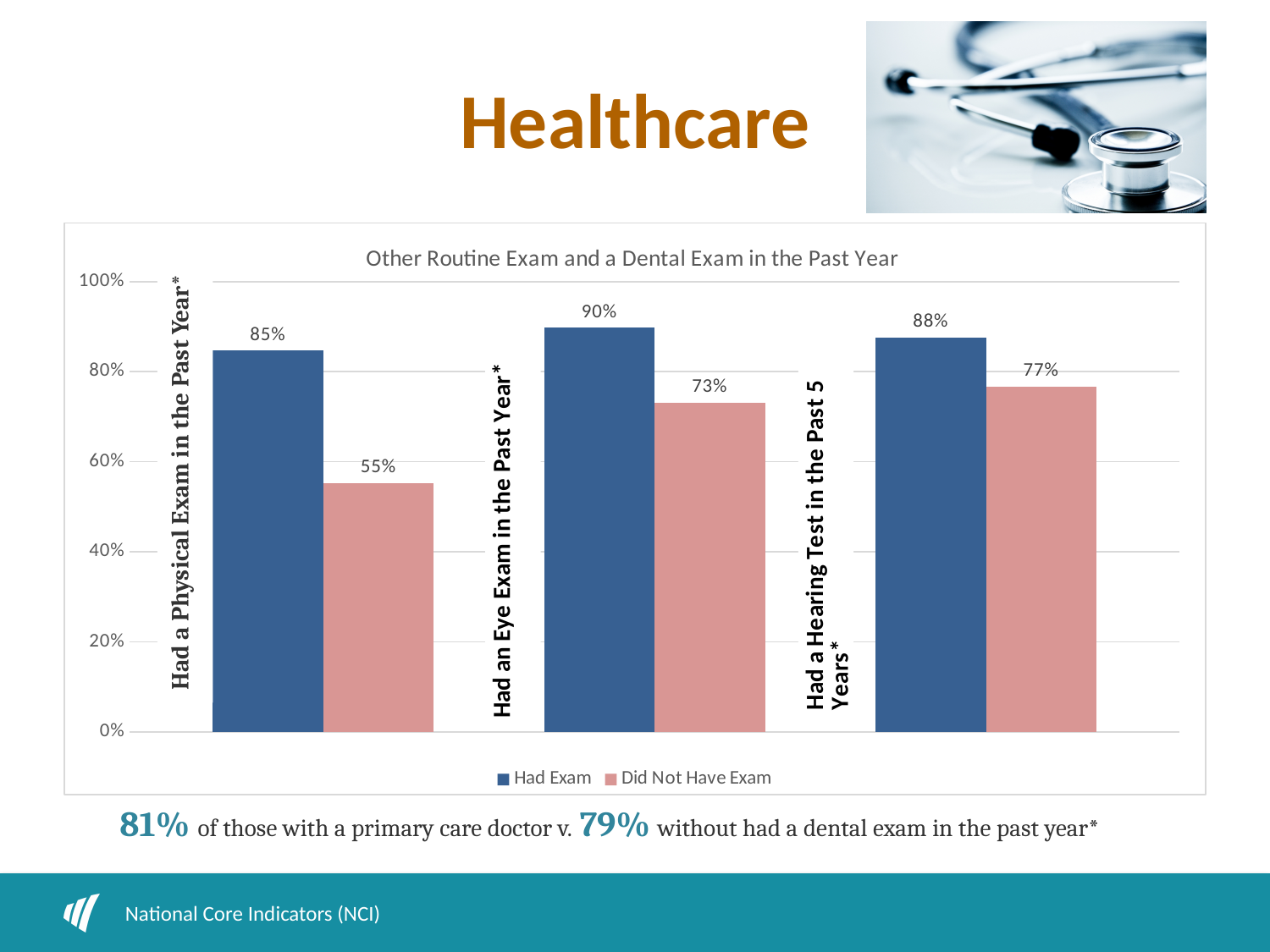
What is the value for "Had Exam" in the "Had a Physical Exam in the Past Year" category? 85% What kind of chart is shown on the slide? Bar chart What is the difference between "Had Exam" and "Did Not Have Exam" for "Had a Hearing Test in the Past 5 Years"? 11% Which category has the highest "Had Exam" value? Had an Eye Exam in the Past Year What is the difference between "Had Exam" and "Did Not Have Exam" for "Had a Physical Exam in the Past Year"? 30% What is the title of the chart? Other Routine Exam and a Dental Exam in the Past Year What is the value for "Did Not Have Exam" in the "Had an Eye Exam in the Past Year" category? 73% Which category has the lowest "Did Not Have Exam" value? Had a Physical Exam in the Past Year Which is larger: "Did Not Have Exam" for the eye exam category or "Did Not Have Exam" for the hearing test category? Hearing test category How many series does the legend list? 2 What is the value for "Had Exam" in the "Had a Hearing Test in the Past 5 Years" category? 88% How many categories are shown on the x axis of the chart? 3